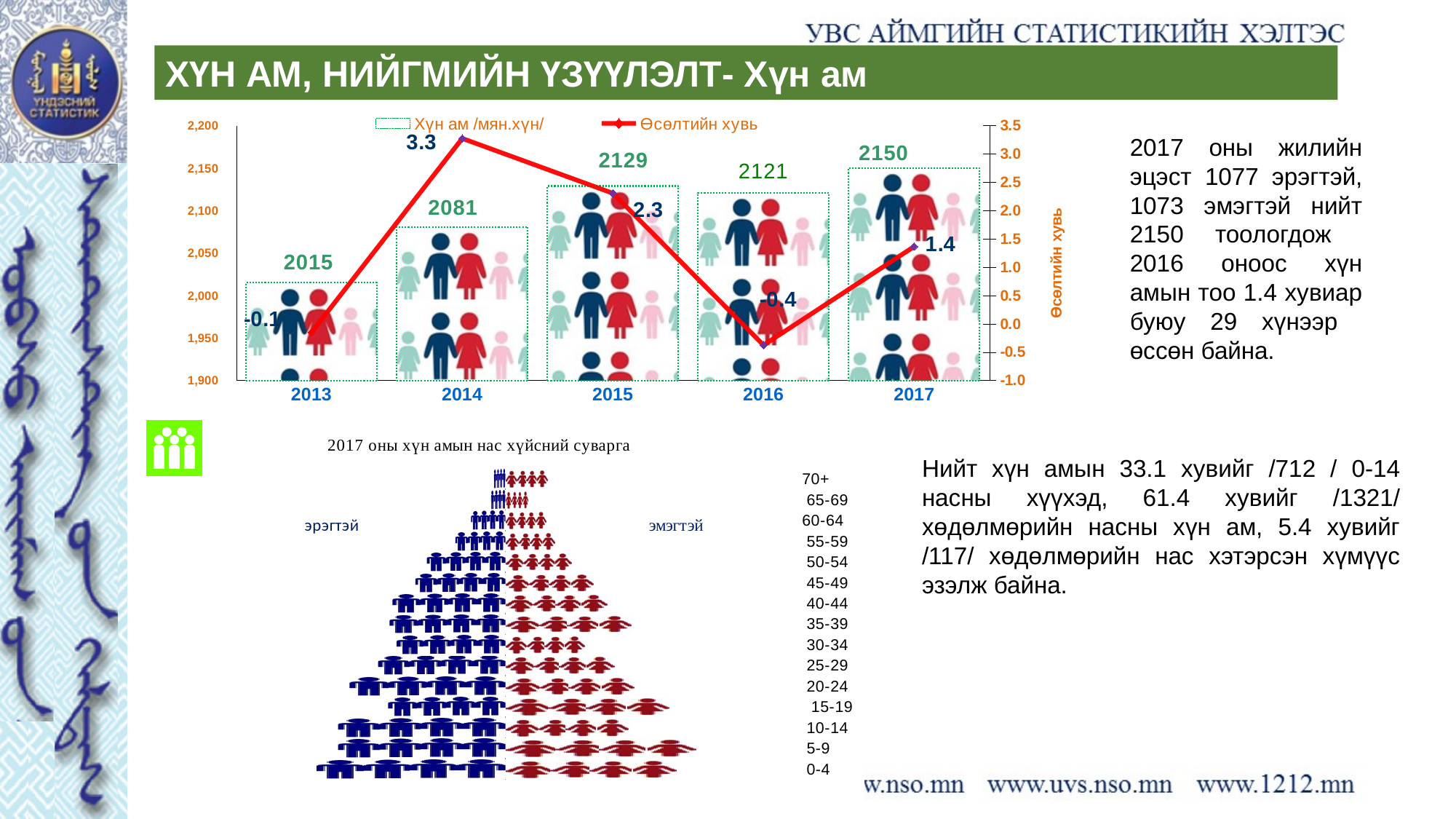
How many years are shown on the x axis of the top chart? 5 How many series does the legend of the top chart list? 2 In the top chart, what is the growth rate (Өсөлтийн хувь) shown for 2015? 2.3 In the top chart, which year has the highest population value? 2017 In the top chart, what is the difference between the population values for 2017 and 2016? 29 In the top chart, what is the growth rate (Өсөлтийн хувь) shown for 2017? 1.4 In the top chart, what is the population value (Хүн ам /мян.хүн/) shown for 2014? 2081 What is the title of the bottom chart on the slide? 2017 оны хүн амын нас хүйсний суварга In the top chart, which year has the highest growth rate (Өсөлтийн хувь)? 2014 In the top chart, which year has the larger population value, 2015 or 2016? 2015 In the top chart, which year has the lowest population value? 2013 In the top chart, which year has the lowest growth rate (Өсөлтийн хувь)? 2016